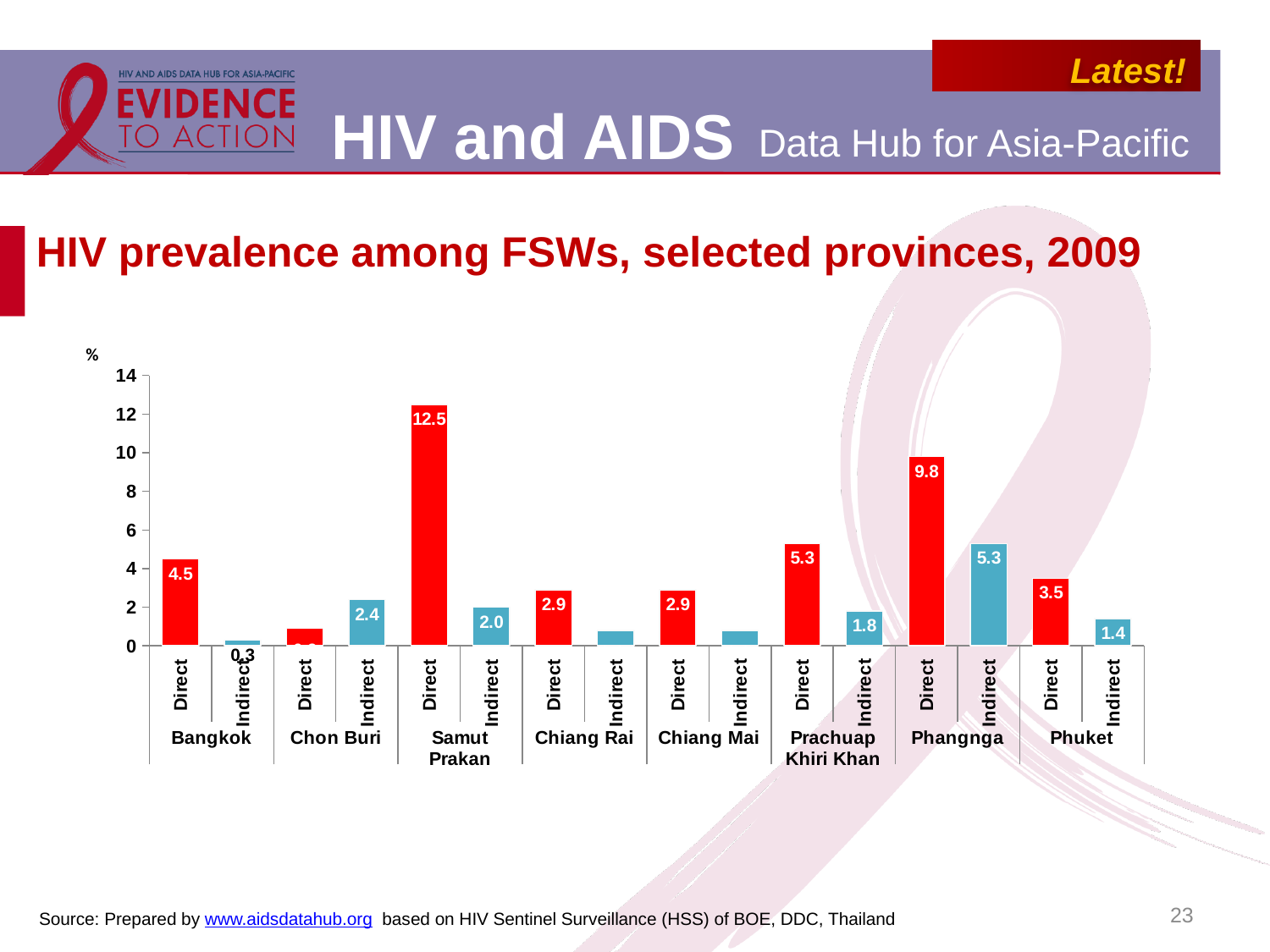
Which is larger: the Direct value for Bangkok or the Direct value for Phuket? Bangkok Direct What type of chart is shown on the slide? bar chart Which bar shows the highest HIV prevalence on the chart? Samut Prakan Direct What is the difference between the Direct and Indirect values for Phangnga? 4.5 What is the HIV prevalence among direct FSWs in Samut Prakan? 12.5 How many provinces are shown on the chart? 8 Is the Indirect value for Chiang Rai greater or less than 2? less What is the HIV prevalence among indirect FSWs in Prachuap Khiri Khan? 1.8 What is the HIV prevalence among indirect FSWs in Phangnga? 5.3 What is the HIV prevalence among indirect FSWs in Chon Buri? 2.4 What is the title of the chart? HIV prevalence among FSWs, selected provinces, 2009 How much higher is the Direct value for Samut Prakan than the Direct value for Phangnga? 2.7